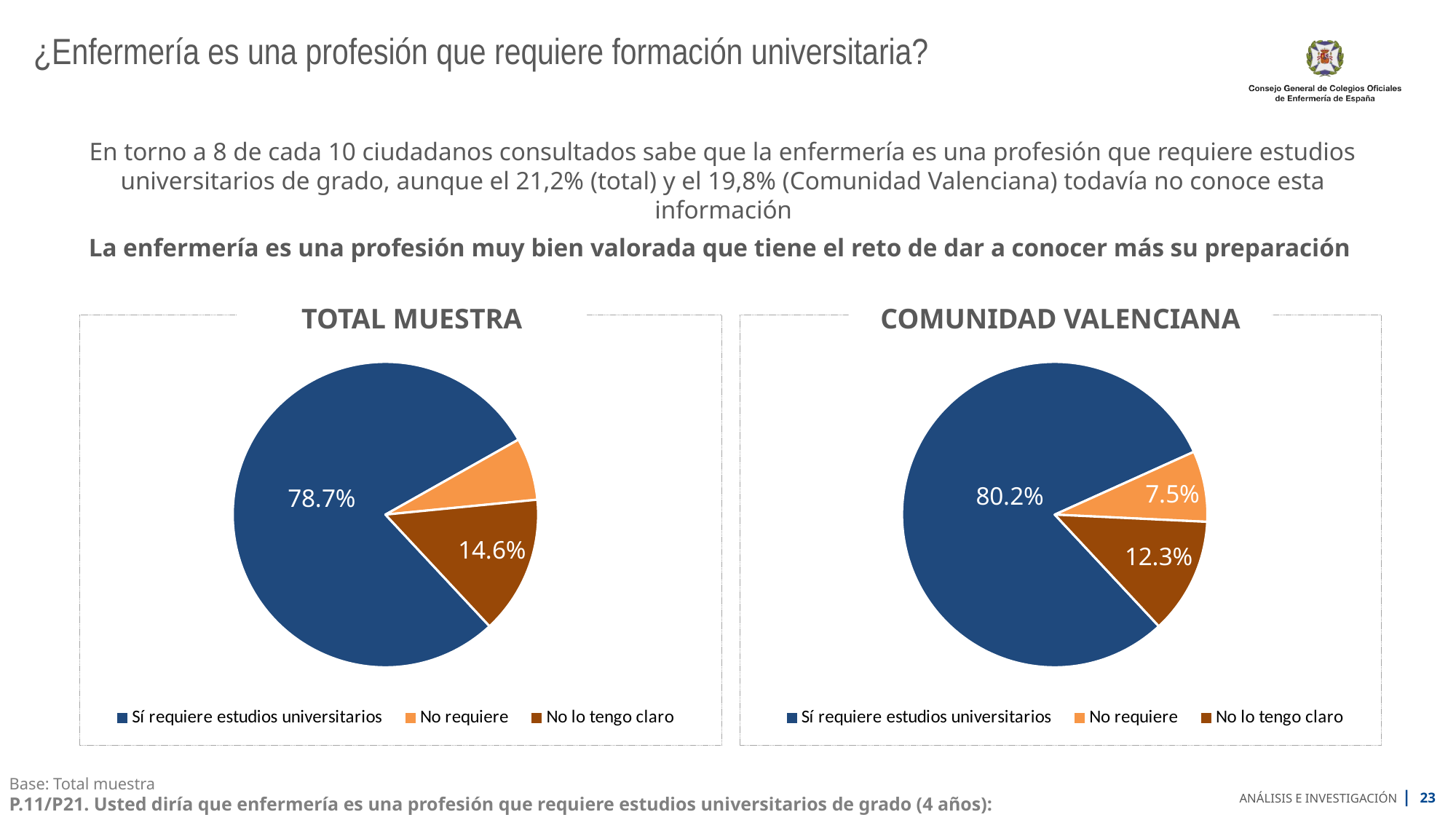
How many response categories does the legend of the TOTAL MUESTRA chart list? 3 In the TOTAL MUESTRA chart, what colour is the 'No lo tengo claro' slice? Brown In the COMUNIDAD VALENCIANA chart, what percentage answered 'No lo tengo claro'? 12.3% In the TOTAL MUESTRA chart, what percentage answered 'Sí requiere estudios universitarios'? 78.7% In the TOTAL MUESTRA chart, which response has the smallest slice? No requiere In the COMUNIDAD VALENCIANA chart, what percentage answered 'No requiere'? 7.5% In the TOTAL MUESTRA chart, what percentage answered 'No lo tengo claro'? 14.6% In the COMUNIDAD VALENCIANA chart, what is the difference between 'Sí requiere estudios universitarios' and 'No lo tengo claro'? 67.9% In the COMUNIDAD VALENCIANA chart, which response has the largest slice? Sí requiere estudios universitarios What type of chart is used for COMUNIDAD VALENCIANA? Pie chart Which chart shows a higher share for 'Sí requiere estudios universitarios', TOTAL MUESTRA or COMUNIDAD VALENCIANA? COMUNIDAD VALENCIANA In the COMUNIDAD VALENCIANA chart, what is the difference between 'No lo tengo claro' and 'No requiere'? 4.8%